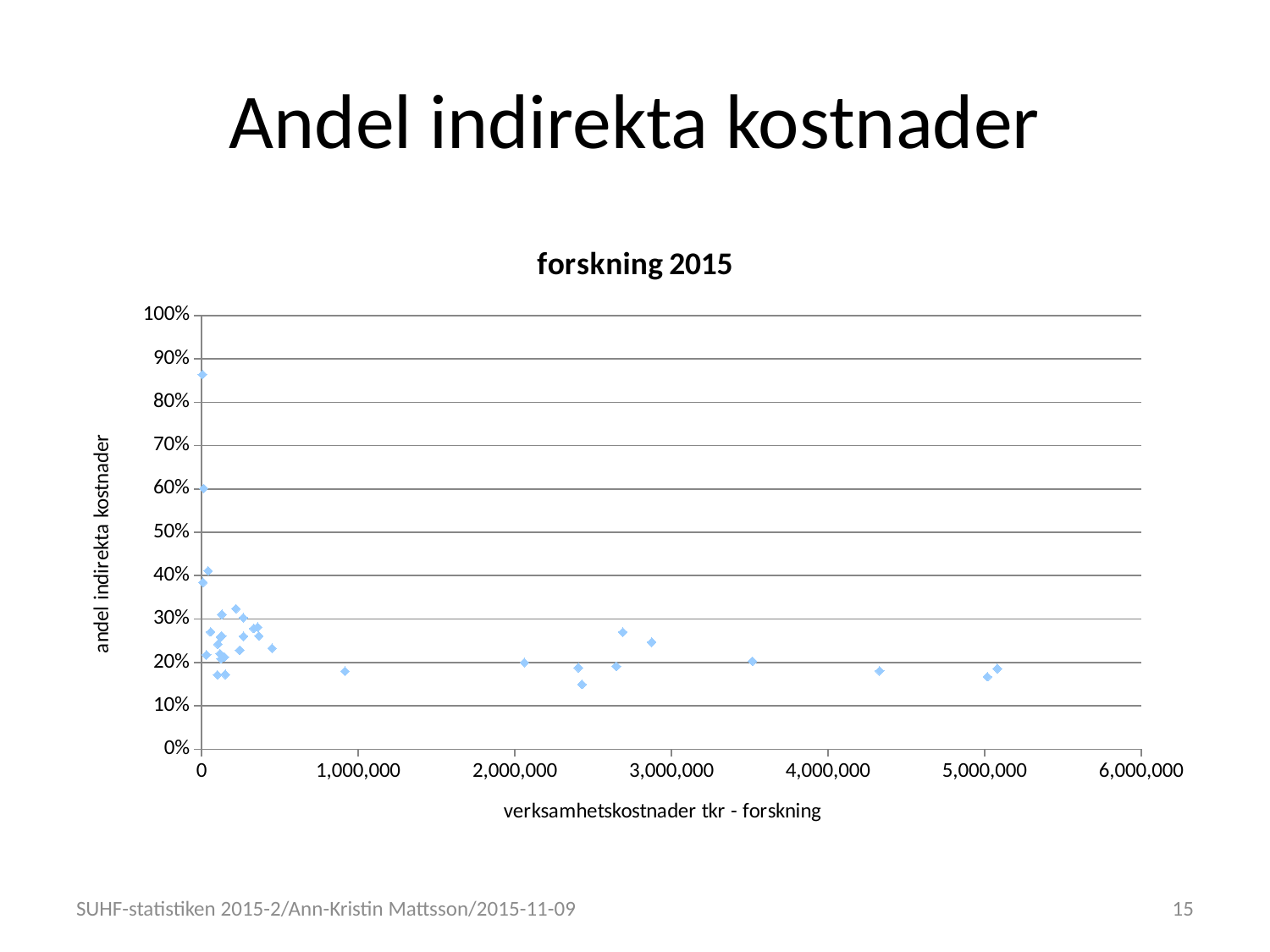
Which has the larger andel indirekta kostnader: the point near 2,700,000 or the point near 5,000,000 on the x axis? the point near 2,700,000 What is the title of the chart? forskning 2015 What is the label of the x axis? verksamhetskostnader tkr - forskning Are all points with verksamhetskostnader above 1,000,000 below 30%? yes What kind of chart is shown on the slide? scatter chart Is the point near 2,700,000 on the x axis greater or less than 30%? less Is the highest point on the chart greater or less than 80% andel indirekta kostnader? greater Do the highest values of andel indirekta kostnader occur at low or high verksamhetskostnader? low